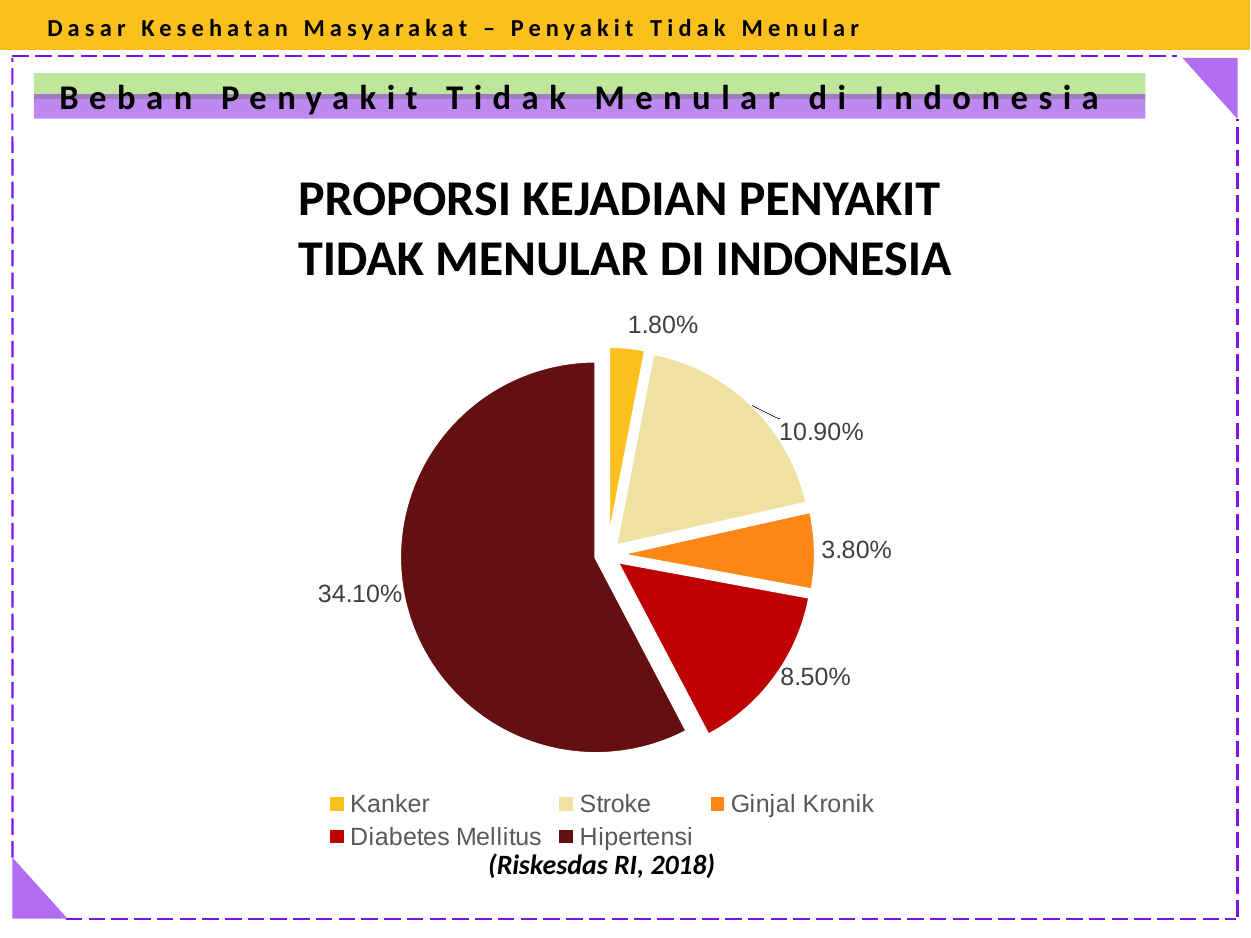
What is the value shown for Ginjal Kronik? 3.80% What is the value shown for Stroke? 10.90% What kind of chart is shown on the slide? pie chart How many categories does the legend list? 5 What is the value shown for Diabetes Mellitus? 8.50% Which category has the largest slice of the pie? Hipertensi Which category has the smallest slice of the pie? Kanker What is the value shown for Hipertensi? 34.10% What is the difference between the values for Hipertensi and Stroke? 23.20% What is the value shown for Kanker? 1.80% What is the title of the chart? PROPORSI KEJADIAN PENYAKIT TIDAK MENULAR DI INDONESIA Which is larger, the value for Diabetes Mellitus or the value for Ginjal Kronik? Diabetes Mellitus